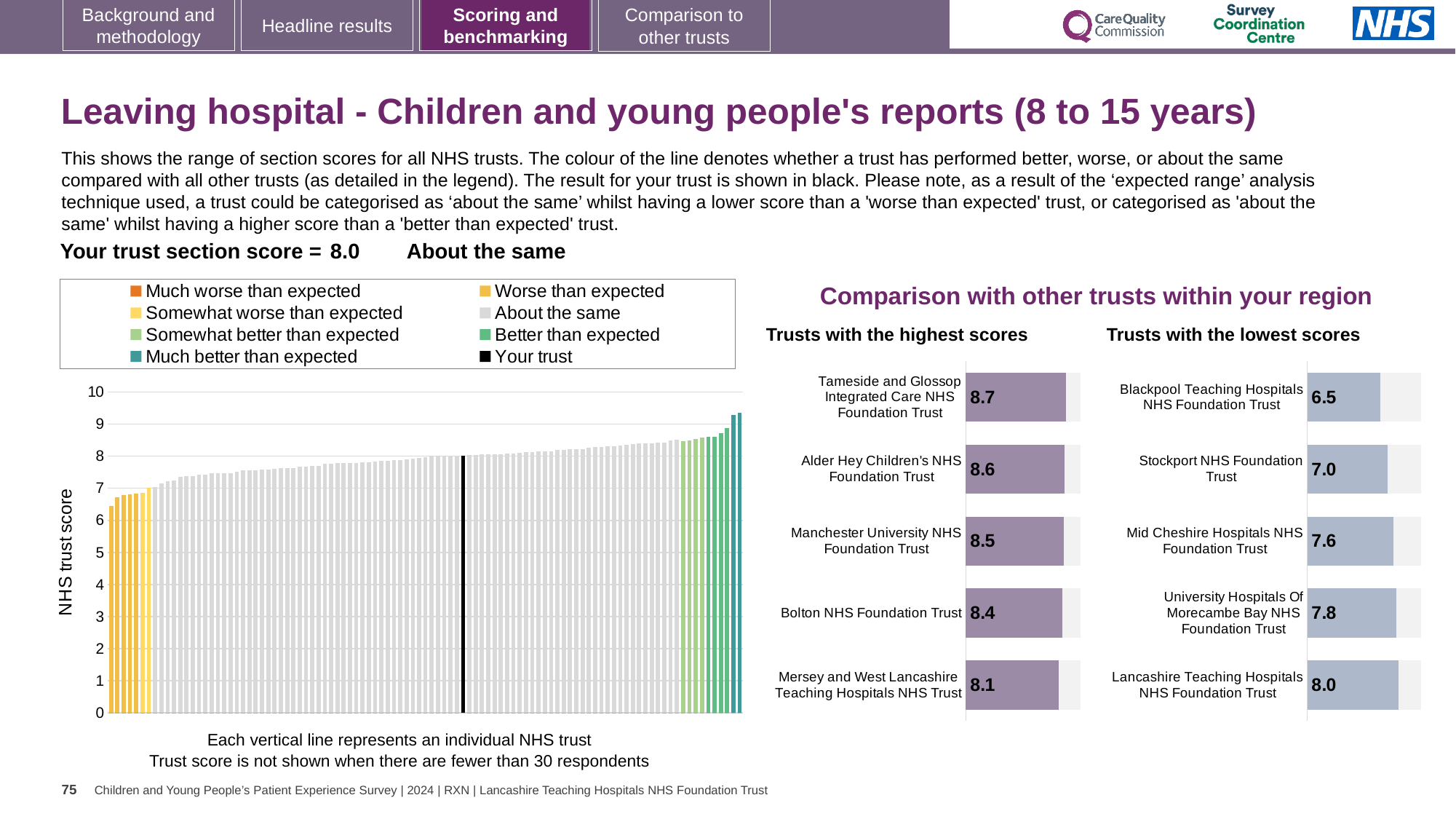
In the 'Trusts with the highest scores' chart, which trust has the lowest score? Mersey and West Lancashire Teaching Hospitals NHS Trust How many entries does the legend above the main NHS trust score chart list? 8 In the 'Trusts with the lowest scores' chart, what is the difference between the scores of Stockport NHS Foundation Trust and Blackpool Teaching Hospitals NHS Foundation Trust? 0.5 In the main NHS trust score chart on the left, is the value of the lowest bar greater or less than 7? less In the main NHS trust score chart on the left, what is the section score for your trust (the black line)? 8.0 In the 'Trusts with the highest scores' chart, what is the difference between the scores of Tameside and Glossop Integrated Care NHS Foundation Trust and Bolton NHS Foundation Trust? 0.3 In the 'Trusts with the lowest scores' chart, which trust has the highest score? Lancashire Teaching Hospitals NHS Foundation Trust In the 'Trusts with the lowest scores' chart, what is the score for Blackpool Teaching Hospitals NHS Foundation Trust? 6.5 In the 'Trusts with the lowest scores' chart, which has the higher score: Mid Cheshire Hospitals NHS Foundation Trust or University Hospitals Of Morecambe Bay NHS Foundation Trust? University Hospitals Of Morecambe Bay NHS Foundation Trust How many trusts are shown in the 'Trusts with the highest scores' chart? 5 In the 'Trusts with the highest scores' chart, what is the score for Tameside and Glossop Integrated Care NHS Foundation Trust? 8.7 In the main NHS trust score chart on the left, do the trust scores rise or fall from left to right? rise